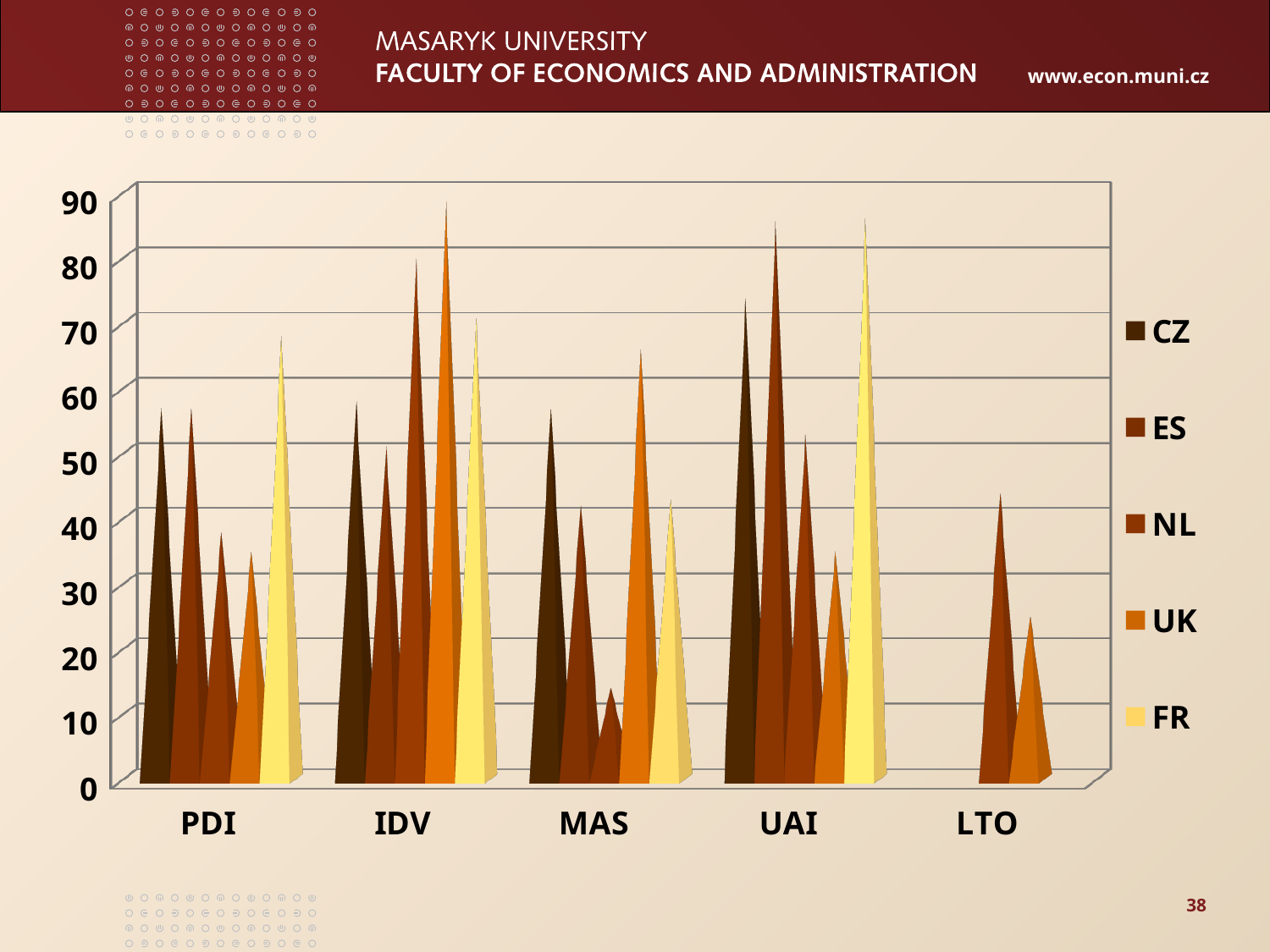
Is the value for NL in the MAS category greater or less than 20? less Which series are listed in the legend? CZ, ES, NL, UK, FR In the PDI category, which is larger: the value for FR or the value for NL? FR Is the value for UK in the IDV category greater or less than 80? greater How many categories are shown along the x axis? 5 Which series has the highest value in the IDV category? UK Is the value for UK in the LTO category greater or less than 30? less Which category has bars for only two series? LTO How many series does the legend list? 5 Which series has the lowest value in the MAS category? NL What kind of chart is shown on the slide? bar chart